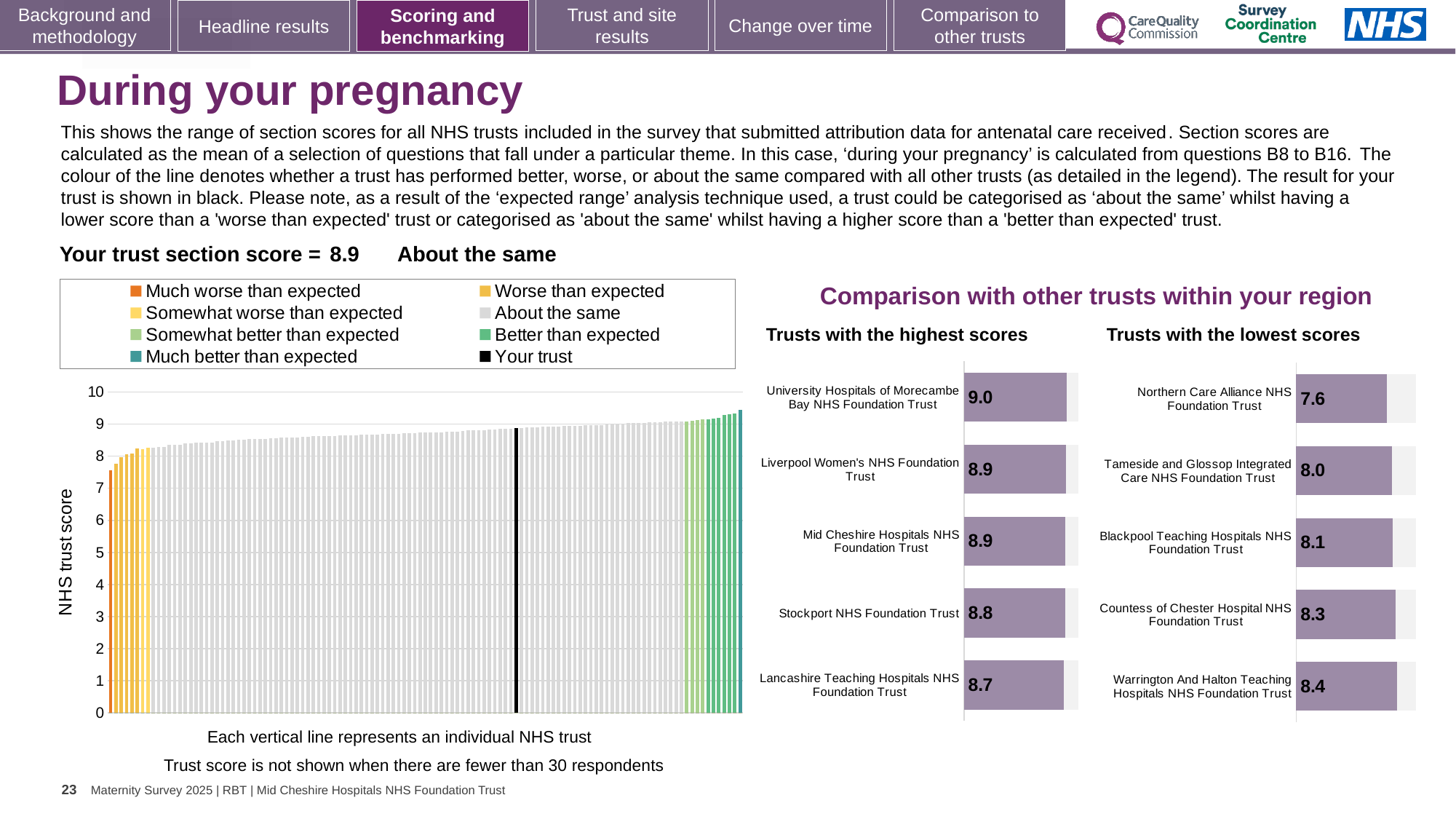
In the main 'NHS trust score' chart on the left, is the value for the black 'Your trust' line greater or less than 8? greater How many trusts are shown in the 'Trusts with the highest scores' chart? 5 In the 'Trusts with the lowest scores' chart, what is the score for Northern Care Alliance NHS Foundation Trust? 7.6 In the 'Trusts with the highest scores' chart, what is the score for Stockport NHS Foundation Trust? 8.8 How many entries does the legend of the main 'NHS trust score' chart on the left list? 8 What kind of chart is the main 'NHS trust score' chart on the left of the slide? bar chart In the 'Trusts with the lowest scores' chart, which has the higher score: Blackpool Teaching Hospitals NHS Foundation Trust or Countess of Chester Hospital NHS Foundation Trust? Countess of Chester Hospital NHS Foundation Trust In the 'Trusts with the lowest scores' chart, what is the difference between the scores of Warrington And Halton Teaching Hospitals NHS Foundation Trust and Northern Care Alliance NHS Foundation Trust? 0.8 In the 'Trusts with the highest scores' chart, what is the difference between the scores of University Hospitals of Morecambe Bay NHS Foundation Trust and Lancashire Teaching Hospitals NHS Foundation Trust? 0.3 In the 'Trusts with the highest scores' chart, which trust has the highest score? University Hospitals of Morecambe Bay NHS Foundation Trust In the 'Trusts with the lowest scores' chart, which trust has the lowest score? Northern Care Alliance NHS Foundation Trust In the 'Trusts with the lowest scores' chart, what is the score for Tameside and Glossop Integrated Care NHS Foundation Trust? 8.0